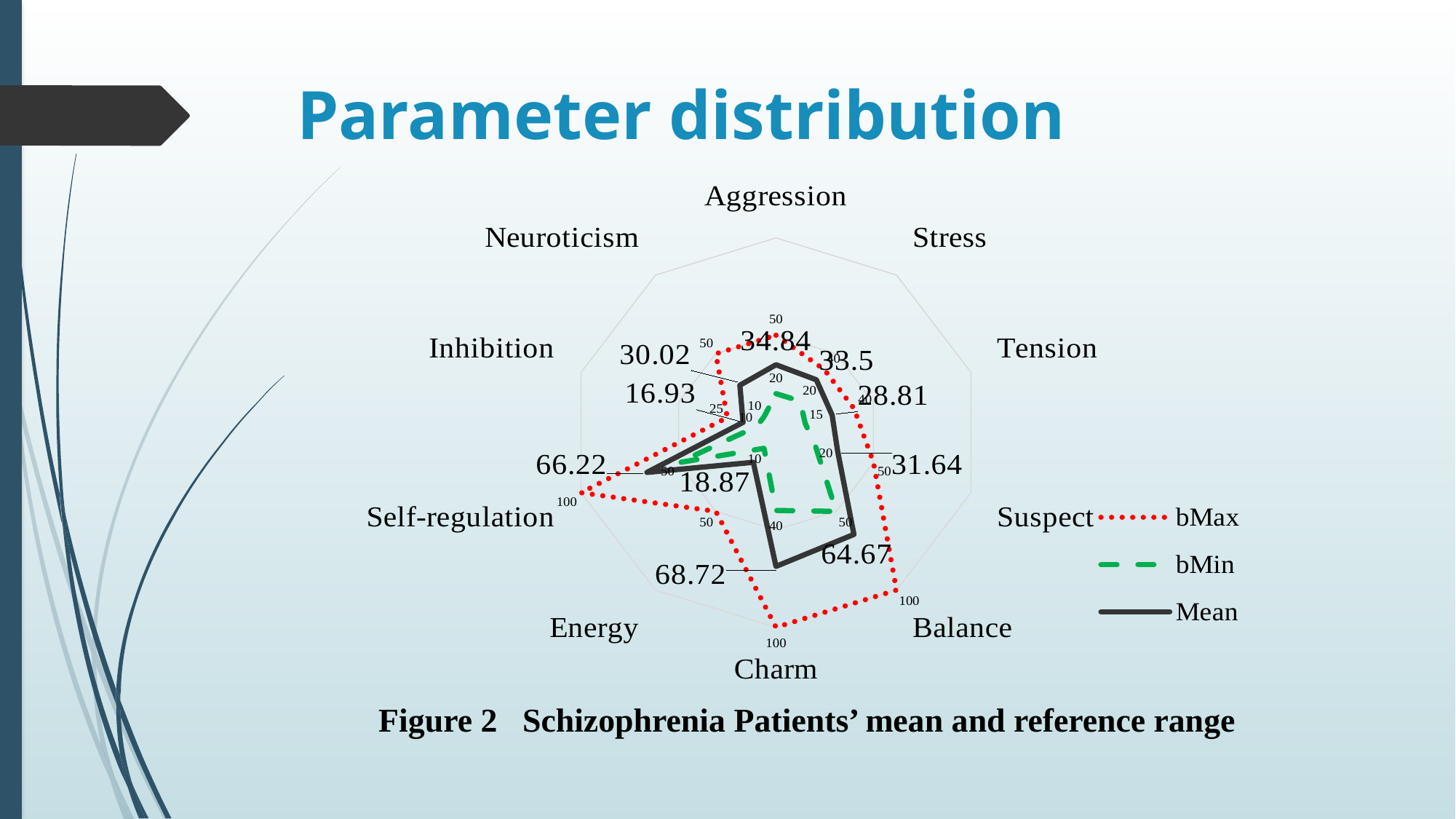
Which category has the highest Mean value? Charm What is the Mean value for Aggression? 34.84 What is the difference between the Mean values for Charm and Balance? 4.05 What is the Mean value for Self-regulation? 66.22 Which category has the lowest Mean value? Inhibition What is the Mean value for Tension? 28.81 How many series does the legend list? 3 How many categories (axes) does the radar chart have? 10 Which has the larger Mean value, Aggression or Stress? Aggression What kind of chart is shown on the slide? Radar chart What is the Mean value for Balance? 64.67 What are the three series named in the legend? bMax, bMin, Mean